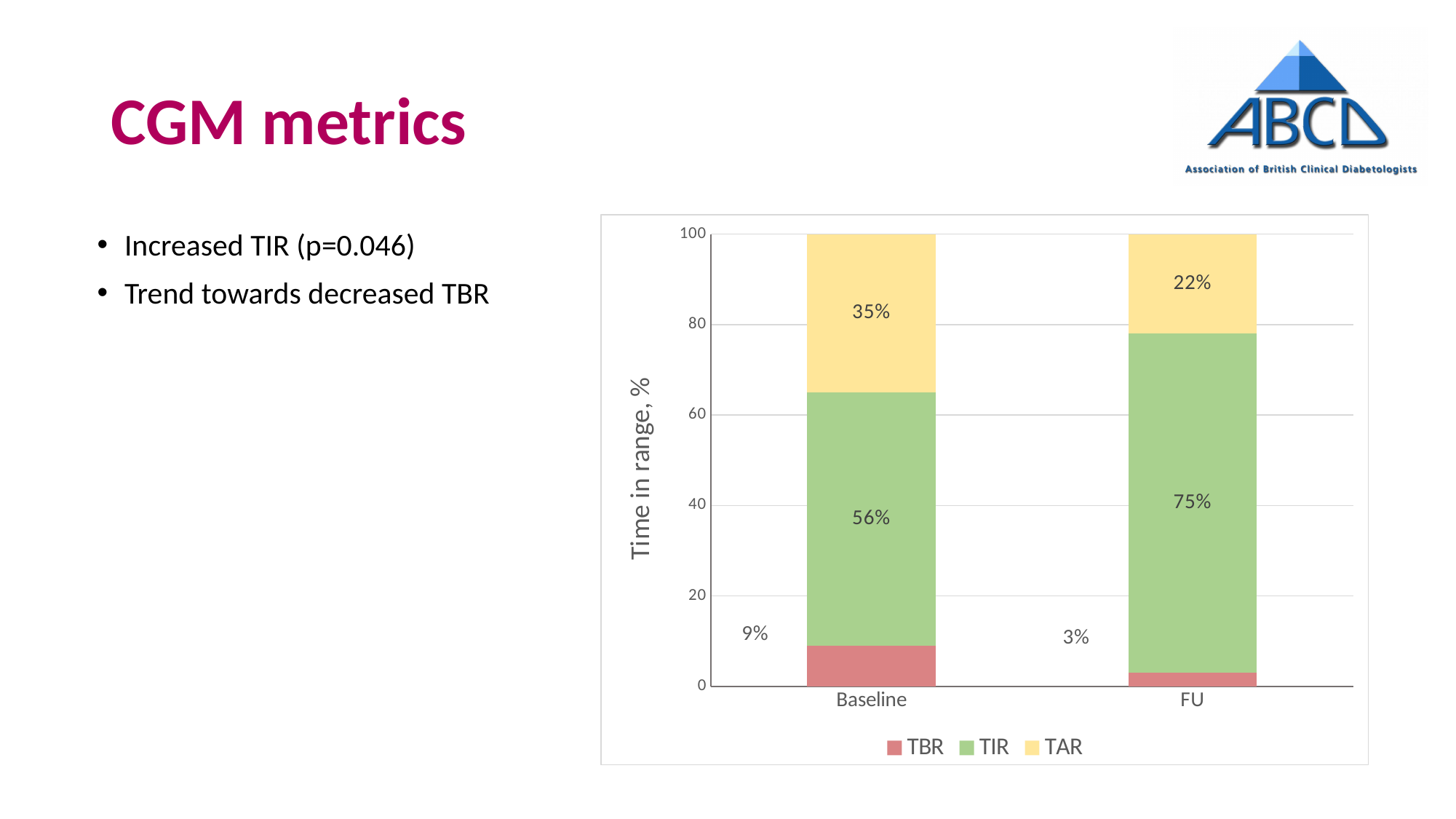
What is the TIR value for FU? 75% Which category has the higher TAR value, Baseline or FU? Baseline What kind of chart is shown on the slide? Stacked bar chart What is the TAR value for Baseline? 35% What is the difference between the TIR values for FU and Baseline? 19% What is the label of the y axis? Time in range, % What is the difference between the TBR values for Baseline and FU? 6% How many series does the legend list? 3 What is the TIR value for Baseline? 56% What is the TBR value for FU? 3% How many categories are shown on the x axis? 2 What is the TBR value for Baseline? 9%